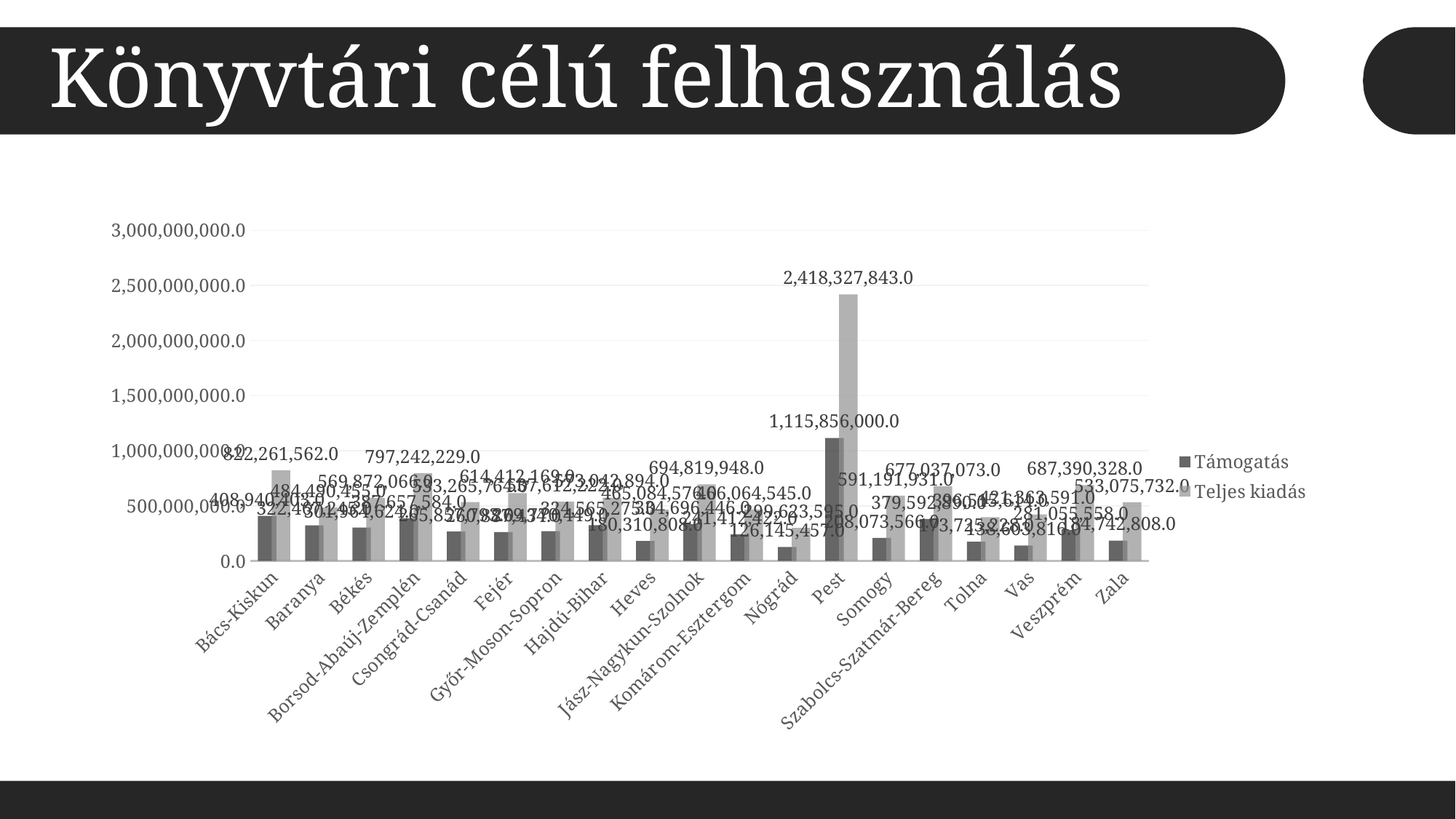
What is the difference between Teljes kiadás and Támogatás for Pest? 1,302,471,843.0 Is the Teljes kiadás value for Pest greater or less than 2,000,000,000.0? greater Which county has the highest Teljes kiadás value? Pest Which county has the highest Támogatás value? Pest What is the Támogatás value for Pest? 1,115,856,000.0 How many series does the legend list? 2 What kind of chart is shown on the slide? bar chart Which is larger, the Teljes kiadás for Bács-Kiskun or for Borsod-Abaúj-Zemplén? Bács-Kiskun What is the Teljes kiadás value for Pest? 2,418,327,843.0 How many counties (categories) are shown on the x axis? 19 What is the Teljes kiadás value for Bács-Kiskun? 822,261,562.0 What are the two series named in the legend? Támogatás and Teljes kiadás